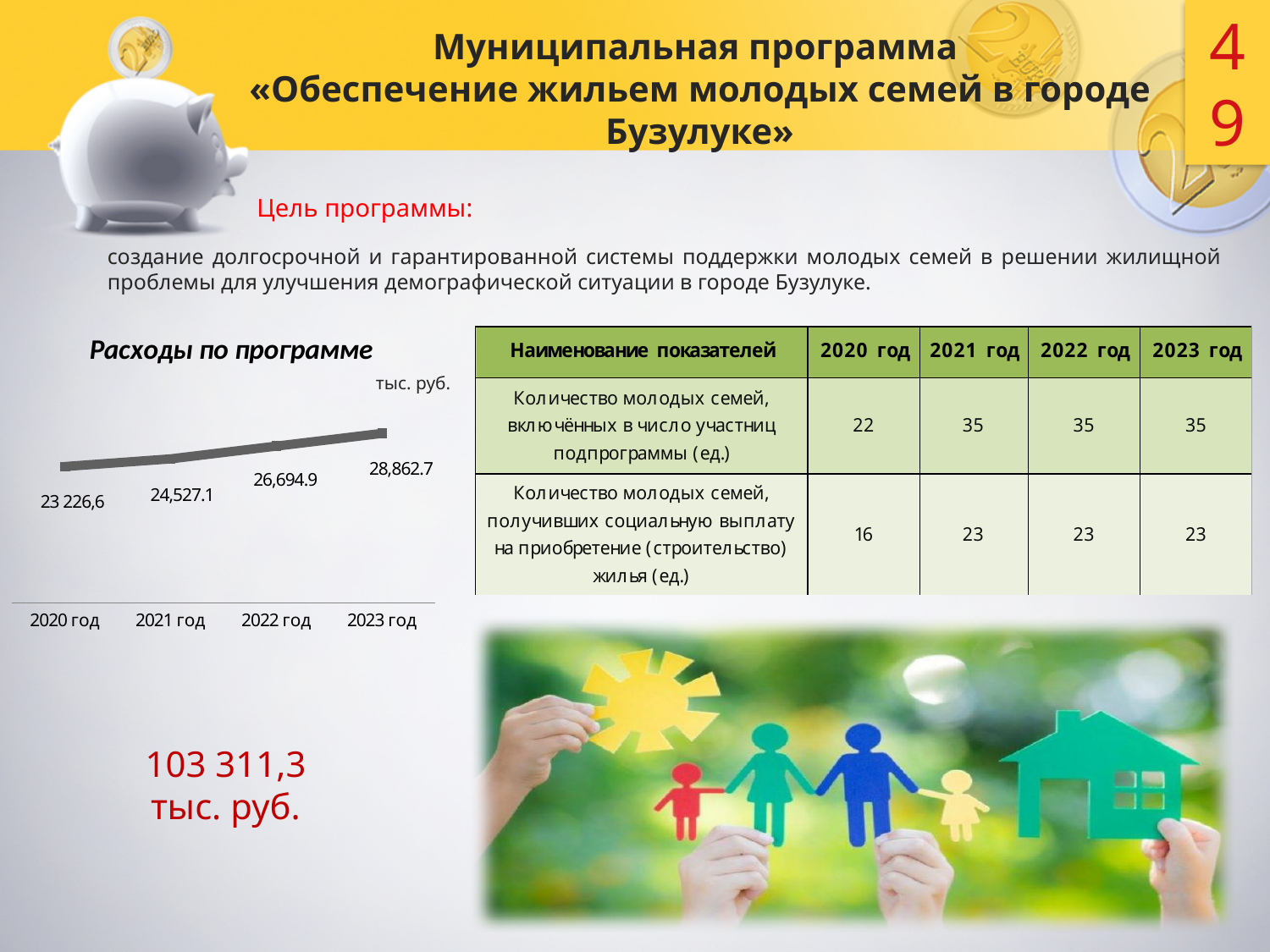
How many years are plotted in the 'Расходы по программе' chart? 4 What unit is shown for the values in the 'Расходы по программе' chart? тыс. руб. Which year has the lowest value in the 'Расходы по программе' chart? 2020 год What is the value for 2023 год in the 'Расходы по программе' chart? 28,862.7 What is the value for 2022 год in the 'Расходы по программе' chart? 26,694.9 Do the values in the 'Расходы по программе' chart rise or fall from 2020 год to 2023 год? rise Which year has the highest value in the 'Расходы по программе' chart? 2023 год What kind of chart is 'Расходы по программе'? line chart In the 'Расходы по программе' chart, what is the difference between the values for 2023 год and 2022 год? 2,167.8 What is the value for 2021 год in the 'Расходы по программе' chart? 24,527.1 What is the value for 2020 год in the 'Расходы по программе' chart? 23 226,6 In the 'Расходы по программе' chart, which is larger: the value for 2021 год or the value for 2022 год? 2022 год